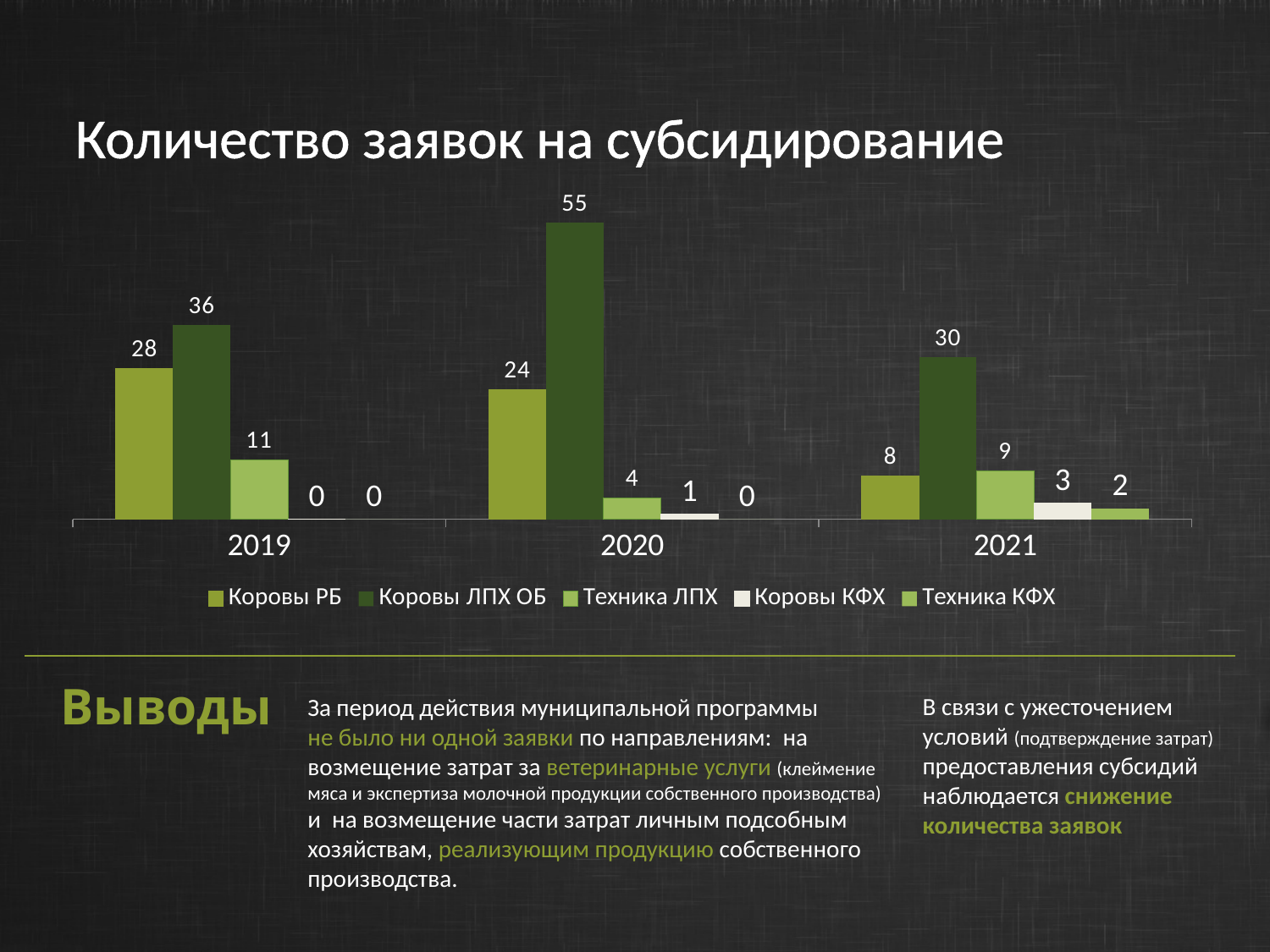
What is the value for Коровы ЛПХ ОБ in 2020? 55 In which year is the value for Коровы РБ lowest? 2021 How many series does the legend list? 5 How many years are shown on the x axis? 3 What is the value for Коровы РБ in 2019? 28 What kind of chart is shown on the slide? Bar chart In which year is the value for Коровы ЛПХ ОБ highest? 2020 Does the value for Коровы РБ rise or fall from 2019 to 2021? Fall What is the value for Коровы КФХ in 2020? 1 What is the value for Техника ЛПХ in 2021? 9 What is the difference between Коровы ЛПХ ОБ and Коровы РБ in 2020? 31 Which is larger in 2021: Техника ЛПХ or Коровы РБ? Техника ЛПХ